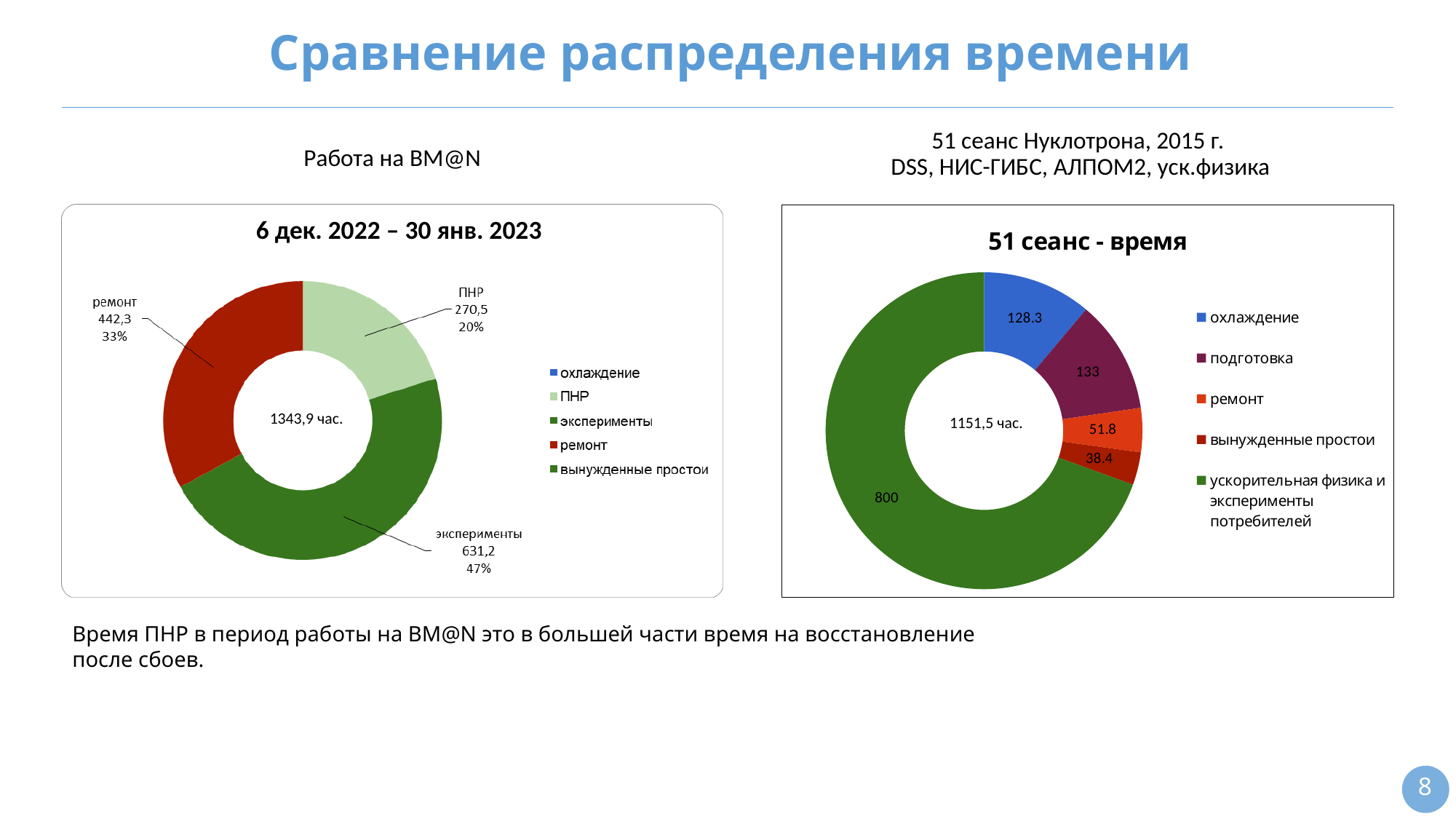
In the chart titled '51 сеанс - время', what is the difference between подготовка and ремонт? 81.2 In the chart titled '6 дек. 2022 – 30 янв. 2023', which category has the largest value? эксперименты In the chart titled '6 дек. 2022 – 30 янв. 2023', what share of the total does ПНР account for? 20% What kind of chart is the chart titled '51 сеанс - время'? doughnut chart In the chart titled '6 дек. 2022 – 30 янв. 2023', what value is shown for эксперименты? 631,2 In the chart titled '51 сеанс - время', what value is shown for охлаждение? 128.3 In the chart titled '6 дек. 2022 – 30 янв. 2023', what share of the total does ремонт account for? 33% In the chart titled '51 сеанс - время', which is larger, охлаждение or подготовка? подготовка In the chart titled '51 сеанс - время', what value is shown for вынужденные простои? 38.4 In the chart titled '6 дек. 2022 – 30 янв. 2023', what total number of hours is shown in the centre of the ring? 1343,9 час. In the chart titled '6 дек. 2022 – 30 янв. 2023', how many entries does the legend list? 5 In the chart titled '51 сеанс - время', which category has the smallest value? вынужденные простои